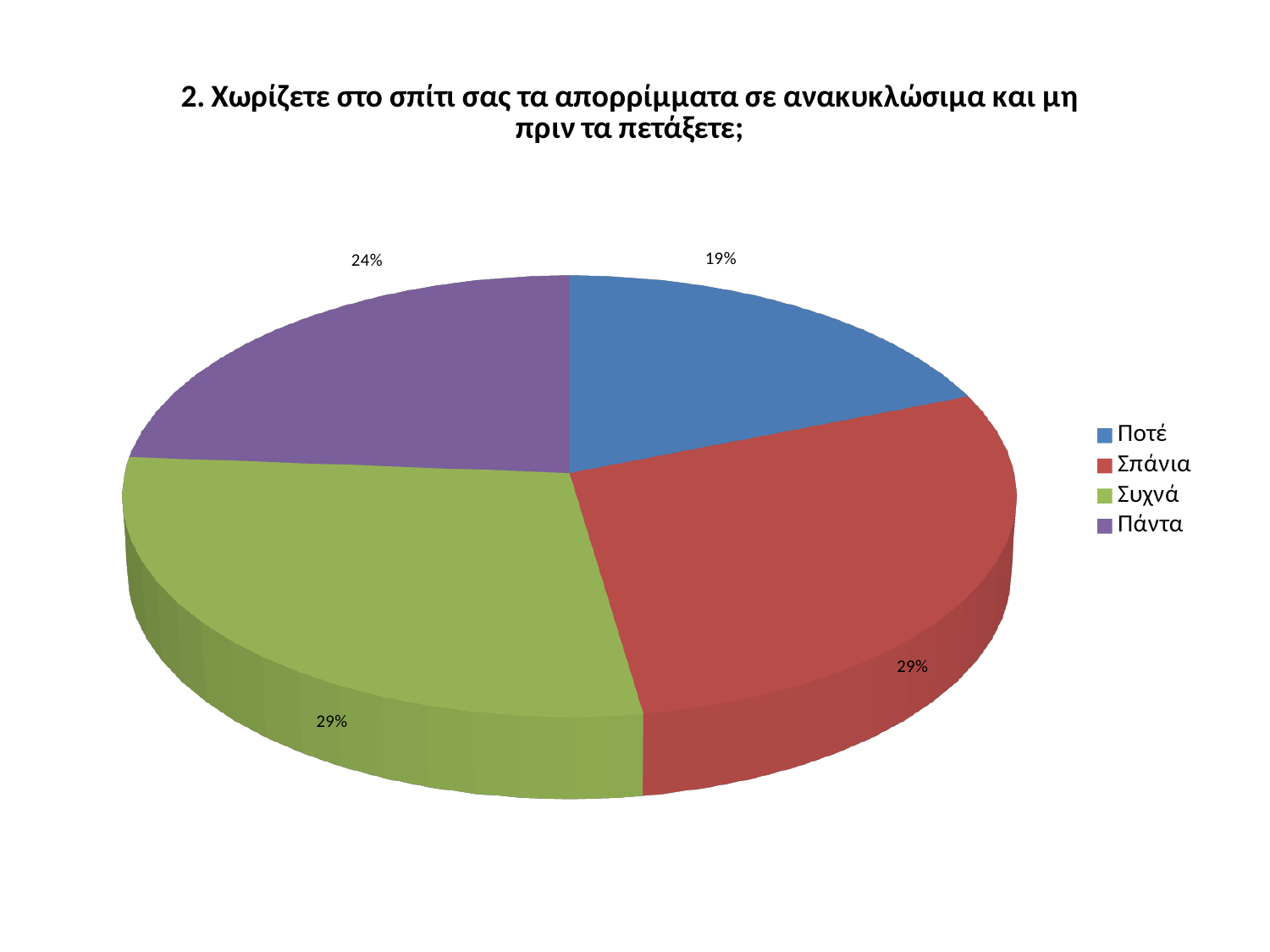
What share of the pie does Πάντα represent? 24% Which category has the smallest slice of the pie? Ποτέ Which is larger, the slice for Ποτέ or the slice for Πάντα? Πάντα What kind of chart is shown on the slide? Pie chart What is the difference in percentage points between the Πάντα slice and the Ποτέ slice? 5 What share of the pie does Συχνά represent? 29% What colour is the slice for Συχνά? Green What is the difference in percentage points between the Συχνά slice and the Ποτέ slice? 10 What share of the pie does Ποτέ represent? 19% Which is larger, the slice for Σπάνια or the slice for Ποτέ? Σπάνια How many categories are shown in the pie chart? 4